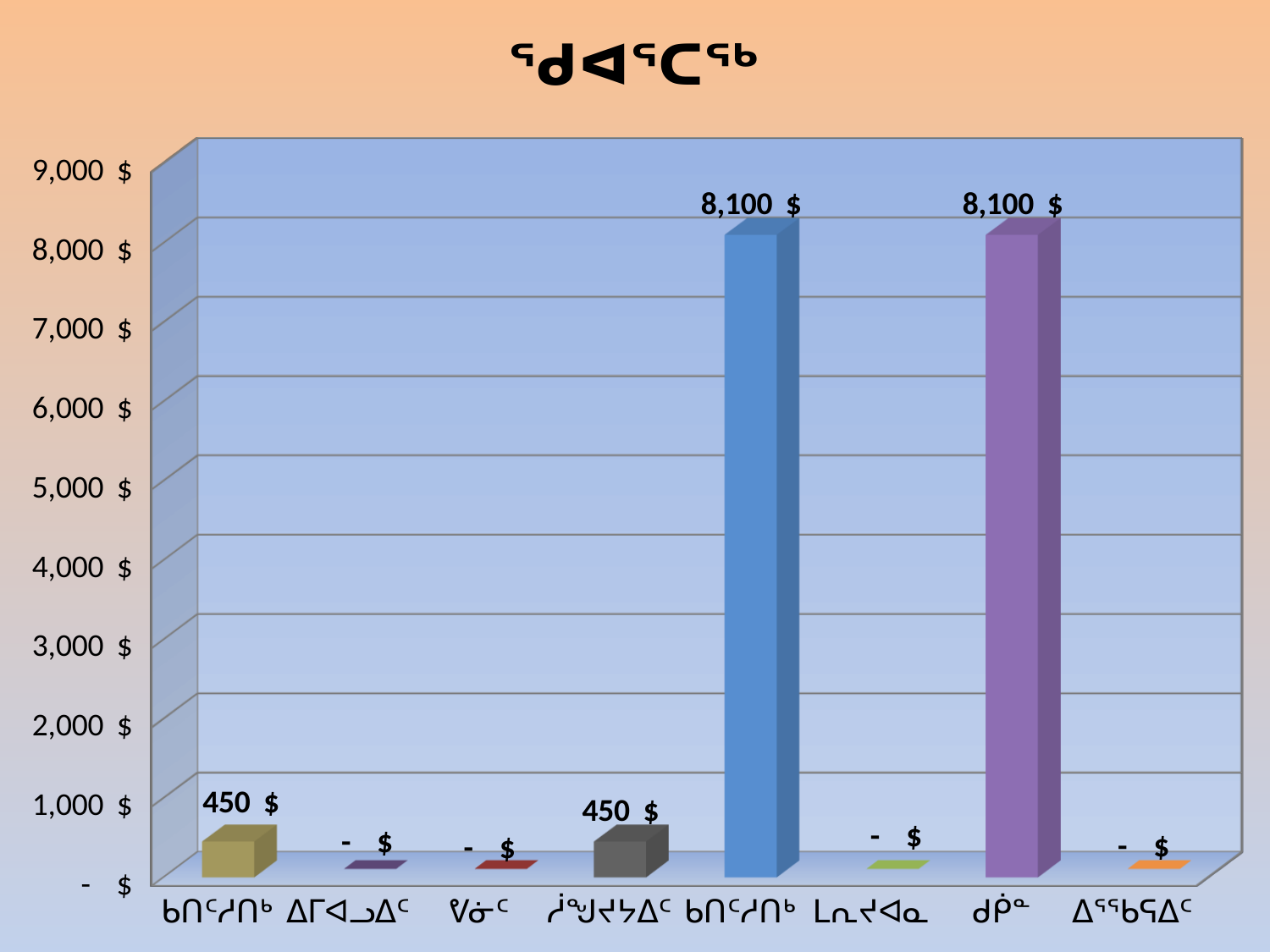
How many bars (categories) are plotted in the chart? 8 What kind of chart is shown on the slide? bar chart Is the value of the first (olive) bar greater or less than 1,000 $? less Which is larger, the value of the purple bar or the value of the dark grey bar? the purple bar What is the data label shown above the last (rightmost, orange) bar? - $ What is the value shown for the fifth (blue) bar? 8,100 $ What is the difference between the value of the blue bar (8,100 $) and the olive bar (450 $)? 7,650 $ Is the value of the blue bar greater or less than 8,000 $? greater What is the value shown for the fourth (dark grey) bar? 450 $ What is the value shown for the first (leftmost, olive-coloured) bar? 450 $ What is the highest value shown on the vertical axis? 9,000 $ What is the value shown for the seventh (purple) bar? 8,100 $